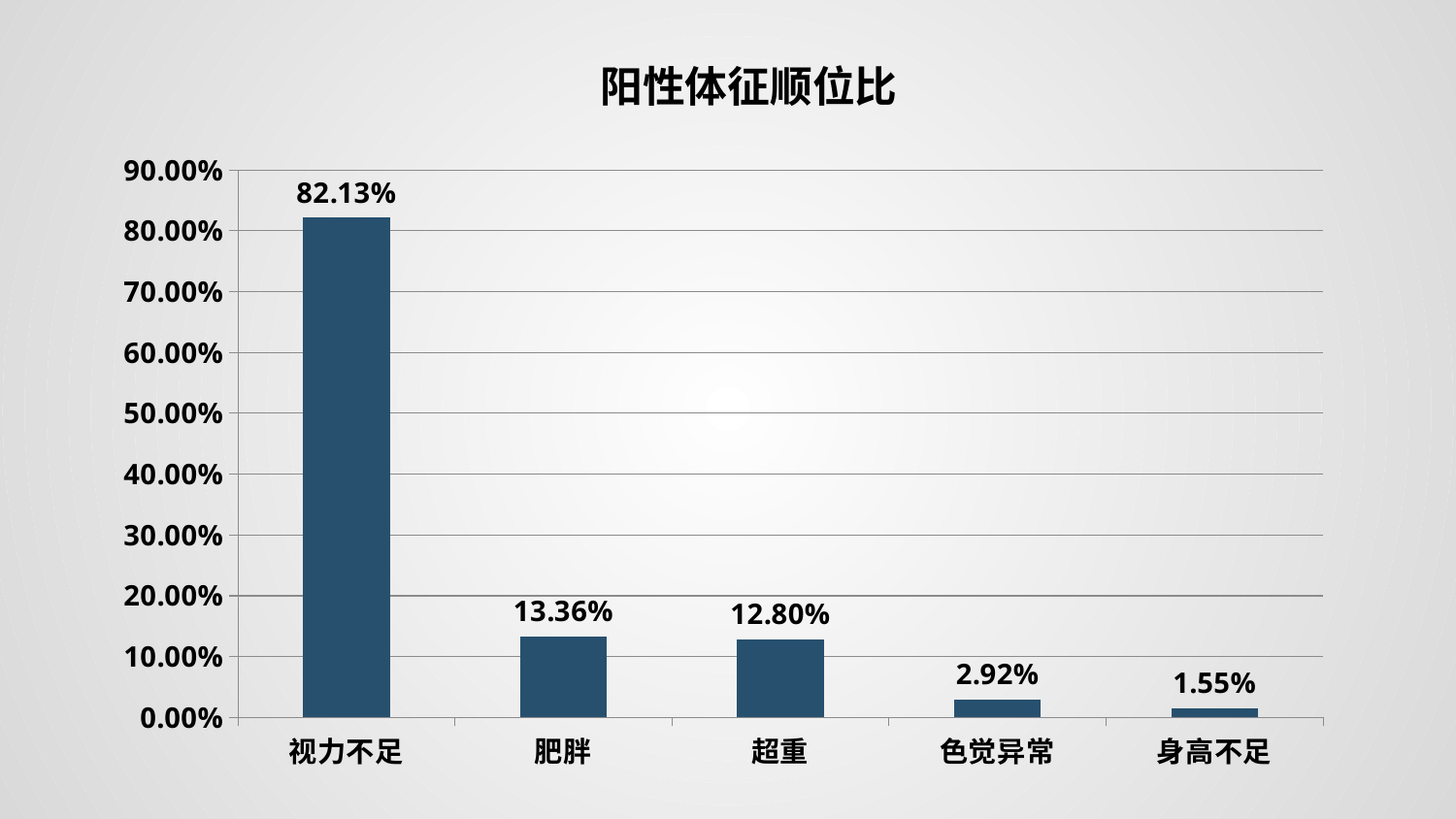
Which is larger, the value for 超重 or the value for 色觉异常? 超重 What is the value for 视力不足? 82.13% What is the value for 身高不足? 1.55% Is the value for 视力不足 greater or less than 80.00%? greater Which category has the highest value? 视力不足 How many categories are shown on the x axis? 5 What is the value for 色觉异常? 2.92% Which category has the lowest value? 身高不足 What is the difference between the values for 肥胖 and 超重? 0.56% What kind of chart is this? bar chart What is the value for 肥胖? 13.36% What is the title of the chart? 阳性体征顺位比